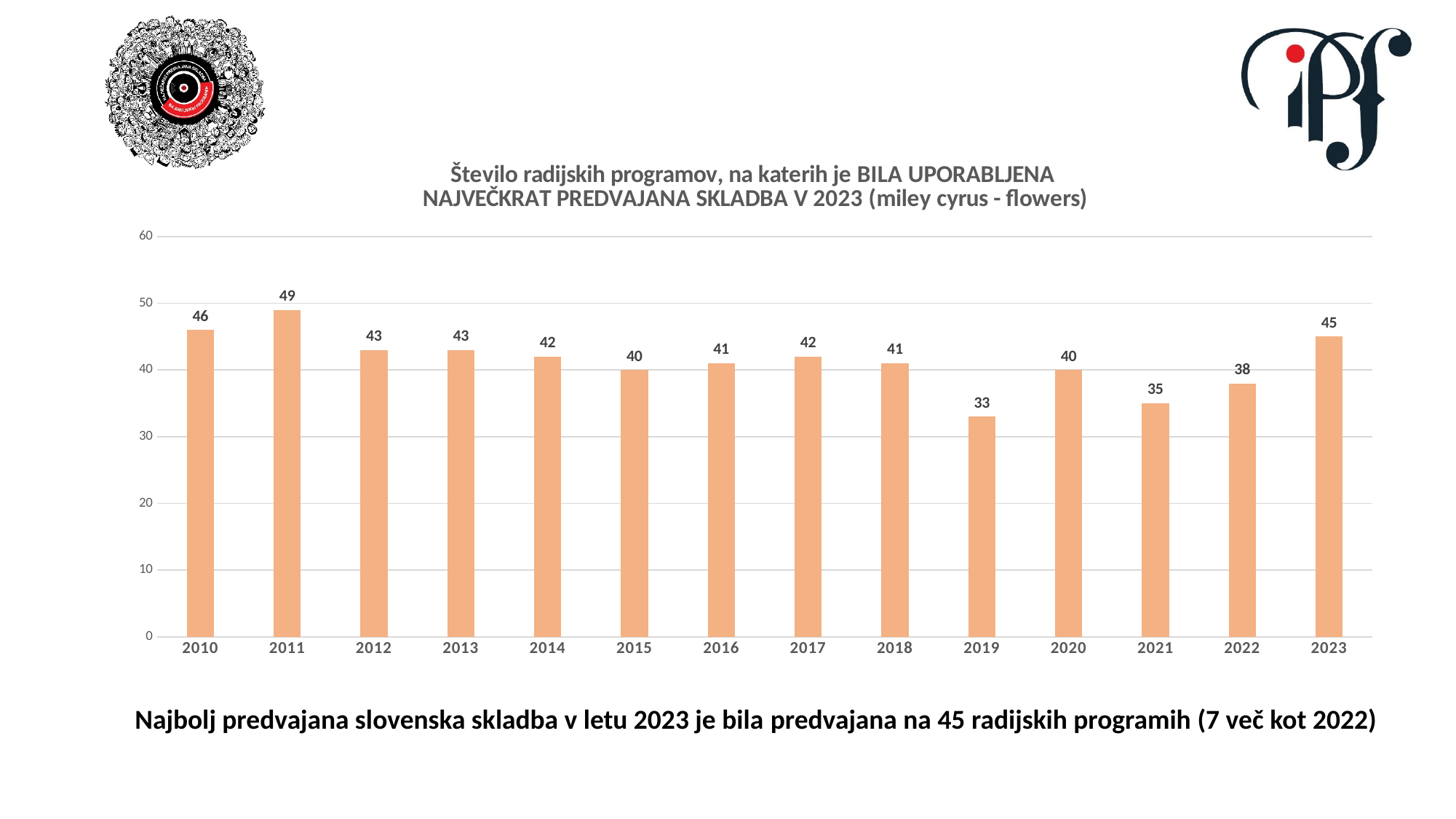
What is the value for 2023? 45 What is the difference between the values for 2011 and 2019? 16 Which year has the highest value? 2011 Which is larger, the value for 2010 or the value for 2021? 2010 How many years are shown on the x axis? 14 What is the value for 2011? 49 Which year has the lowest value? 2019 Do the values rise or fall from 2019 to 2023? rise What is the value for 2019? 33 What is the difference between the values for 2023 and 2022? 7 Is the value for 2019 greater or less than 40? less What kind of chart is shown on the slide? bar chart